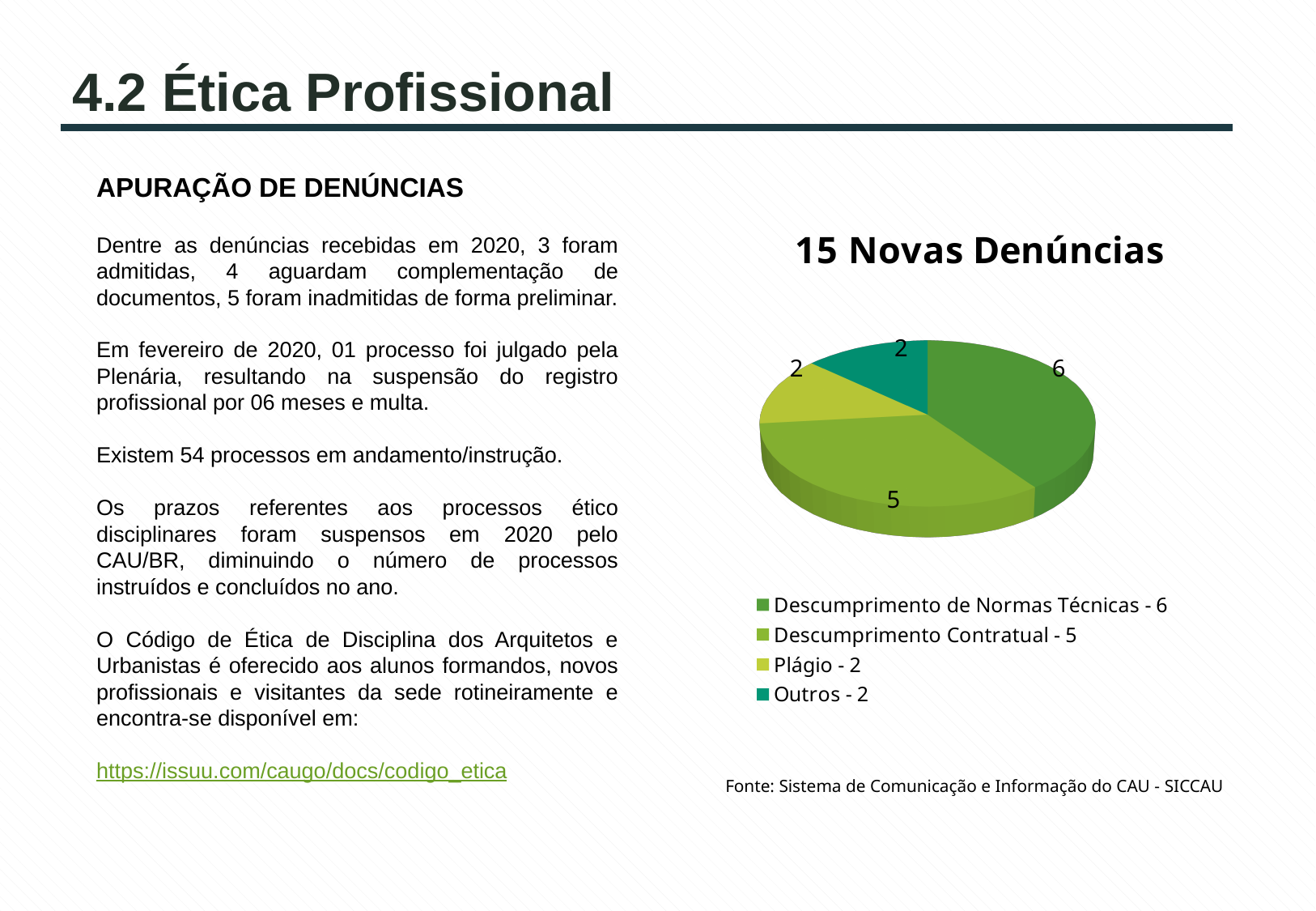
What is the value for Descumprimento Contratual? 5 Which category has the largest slice of the pie? Descumprimento de Normas Técnicas What is the value for Descumprimento de Normas Técnicas? 6 Which is larger, the value for Descumprimento Contratual or the value for Plágio? Descumprimento Contratual What is the value for Plágio? 2 How many slices does the pie chart have? 4 What is the title of the chart? 15 Novas Denúncias What is the difference between the values for Descumprimento de Normas Técnicas and Descumprimento Contratual? 1 What is the total of all slices in the pie chart? 15 What share of the pie does Descumprimento de Normas Técnicas represent? 40% What type of chart is shown on the slide? Pie chart What is the value for Outros? 2